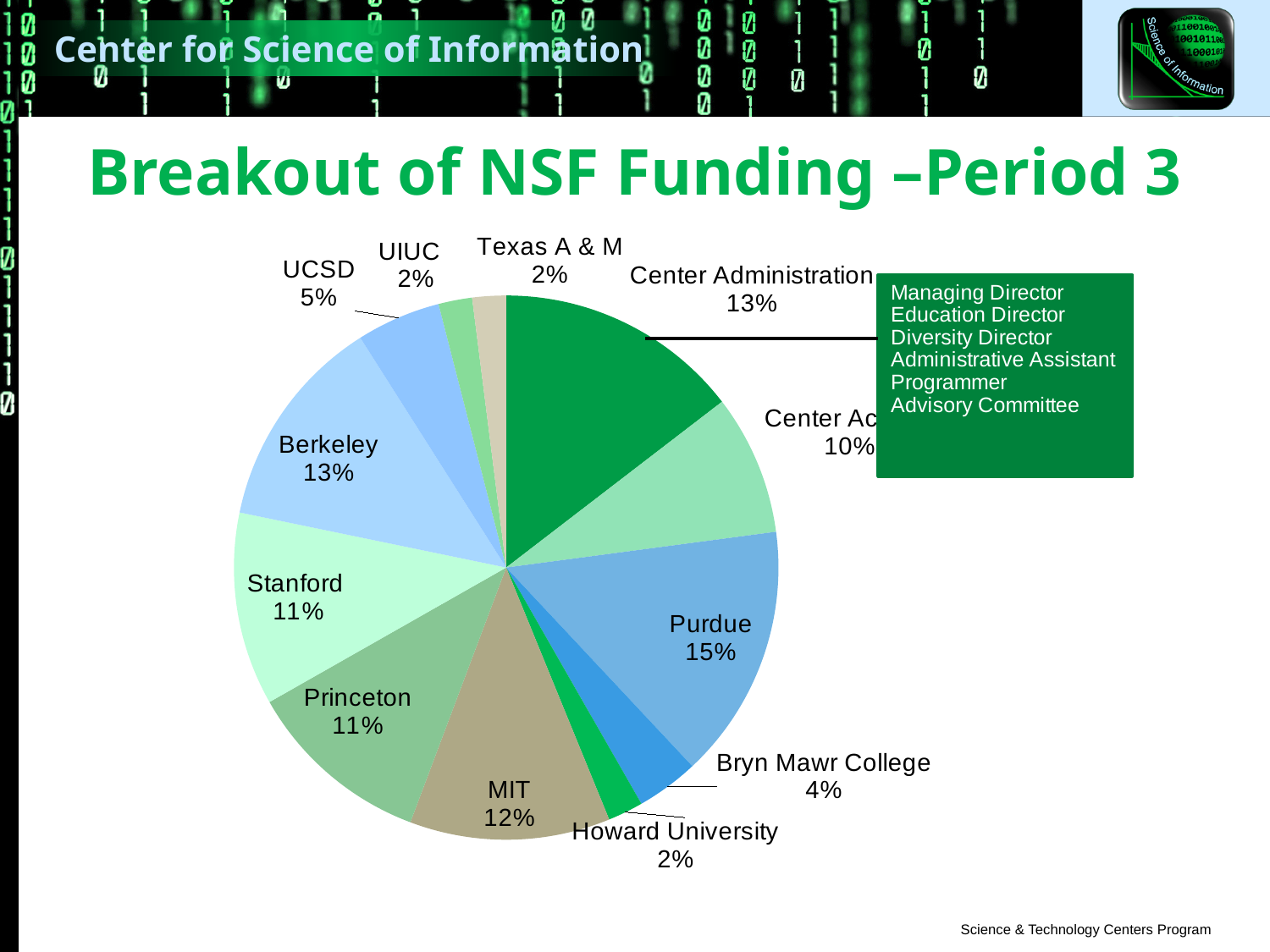
What is the title of the chart on the slide? Breakout of NSF Funding –Period 3 What share of the funding does MIT receive? 12% What share of the funding does UCSD receive? 5% What share of NSF funding goes to Purdue? 15% How many slices does the pie chart have? 12 What kind of chart is shown on the slide? Pie chart What is the difference in percentage points between Purdue's share and MIT's share? 3% What percentage of the funding is allocated to Center Administration? 13% Which receives a larger share of funding, Berkeley or Stanford? Berkeley What is the combined share of Princeton and Stanford? 22% Which institution receives the largest share of NSF funding in the chart? Purdue What percentage of the funding goes to Bryn Mawr College? 4%